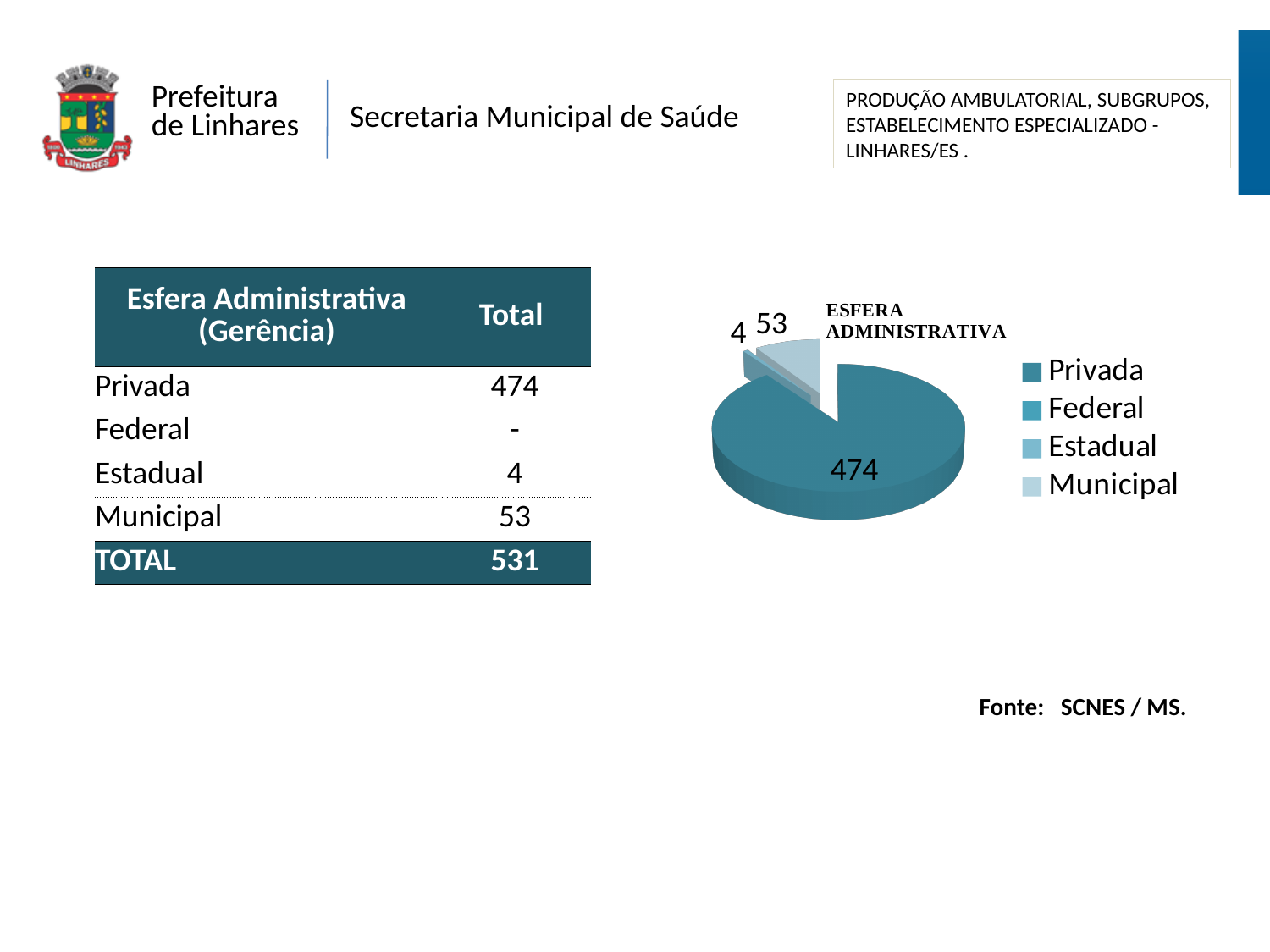
How many entries does the legend of the pie chart list? 4 What is the difference between the Municipal value and the Estadual value in the pie chart? 49 What is the difference between the Privada value and the Municipal value in the pie chart? 421 Which is larger in the pie chart, Municipal or Estadual? Municipal Which entries are listed in the chart's legend? Privada, Federal, Estadual, Municipal What value is shown for the Municipal slice in the pie chart? 53 What value is shown for the Estadual slice in the pie chart? 4 What is the title of the chart? ESFERA ADMINISTRATIVA What kind of chart is shown on the slide? Pie chart Of the slices labelled with a value in the pie chart, which is the smallest? Estadual Which category has the largest slice in the pie chart? Privada What value is shown for the Privada slice in the pie chart? 474